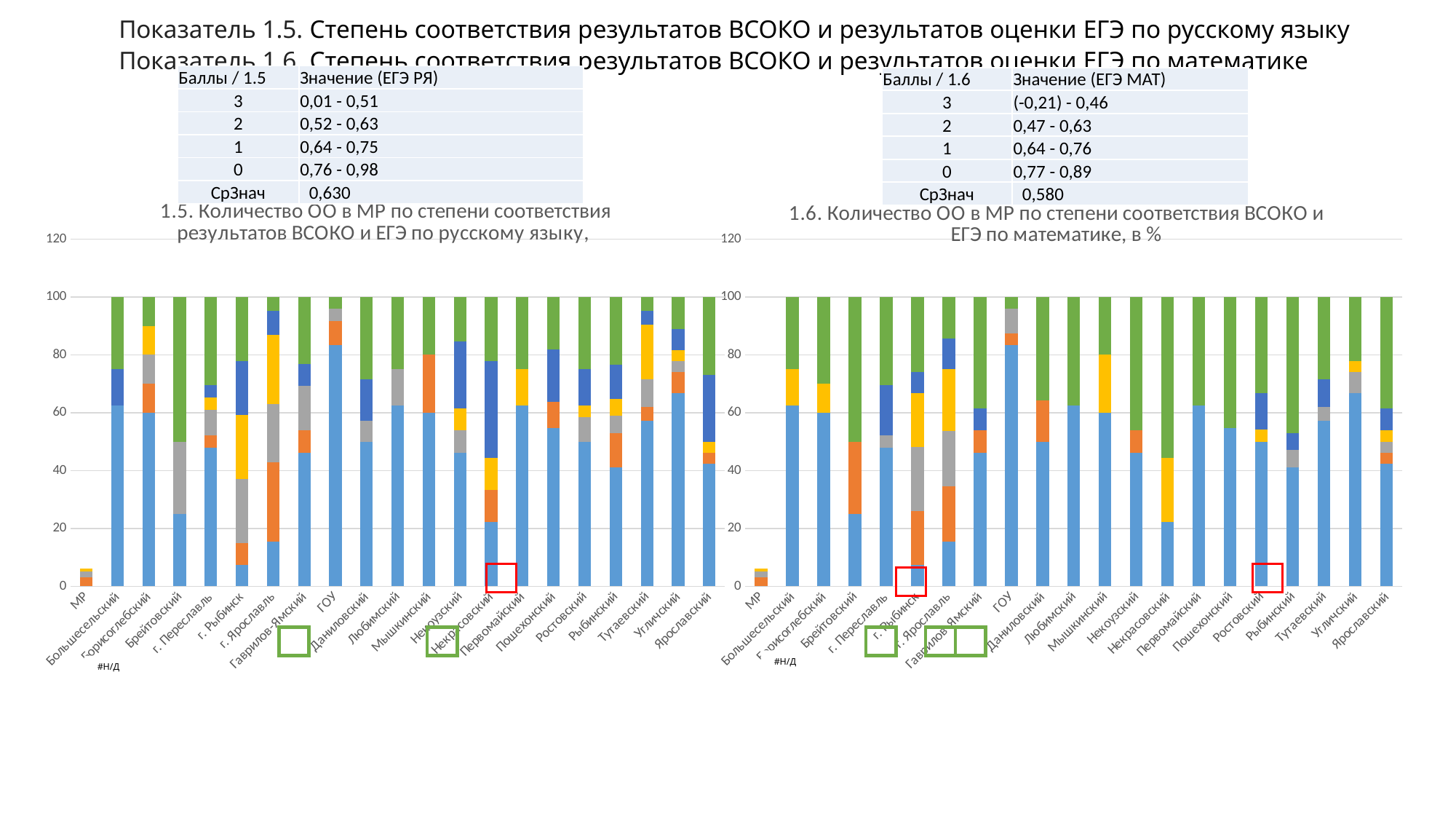
In the left chart (1.5), is the blue segment for Брейтовский greater or less than 40? less In the left chart (1.5), is the blue segment for ГОУ greater or less than 80? greater What is the title of the right chart? 1.6. Количество ОО в МР по степени соответствия ВСОКО и ЕГЭ по математике, в % In the left chart (1.5), is the blue segment for г. Рыбинск greater or less than 20? less How many categories are shown on the x axis of the right chart (1.6)? 21 How many categories are shown on the x axis of the left chart (1.5)? 21 What is the highest value shown on the y axis of the left chart (1.5)? 120 What kind of chart is the left chart titled "1.5. Количество ОО в МР по степени соответствия результатов ВСОКО и ЕГЭ по русскому языку"? Stacked bar chart What kind of chart is the right chart titled "1.6. Количество ОО в МР по степени соответствия ВСОКО и ЕГЭ по математике, в %"? Stacked bar chart